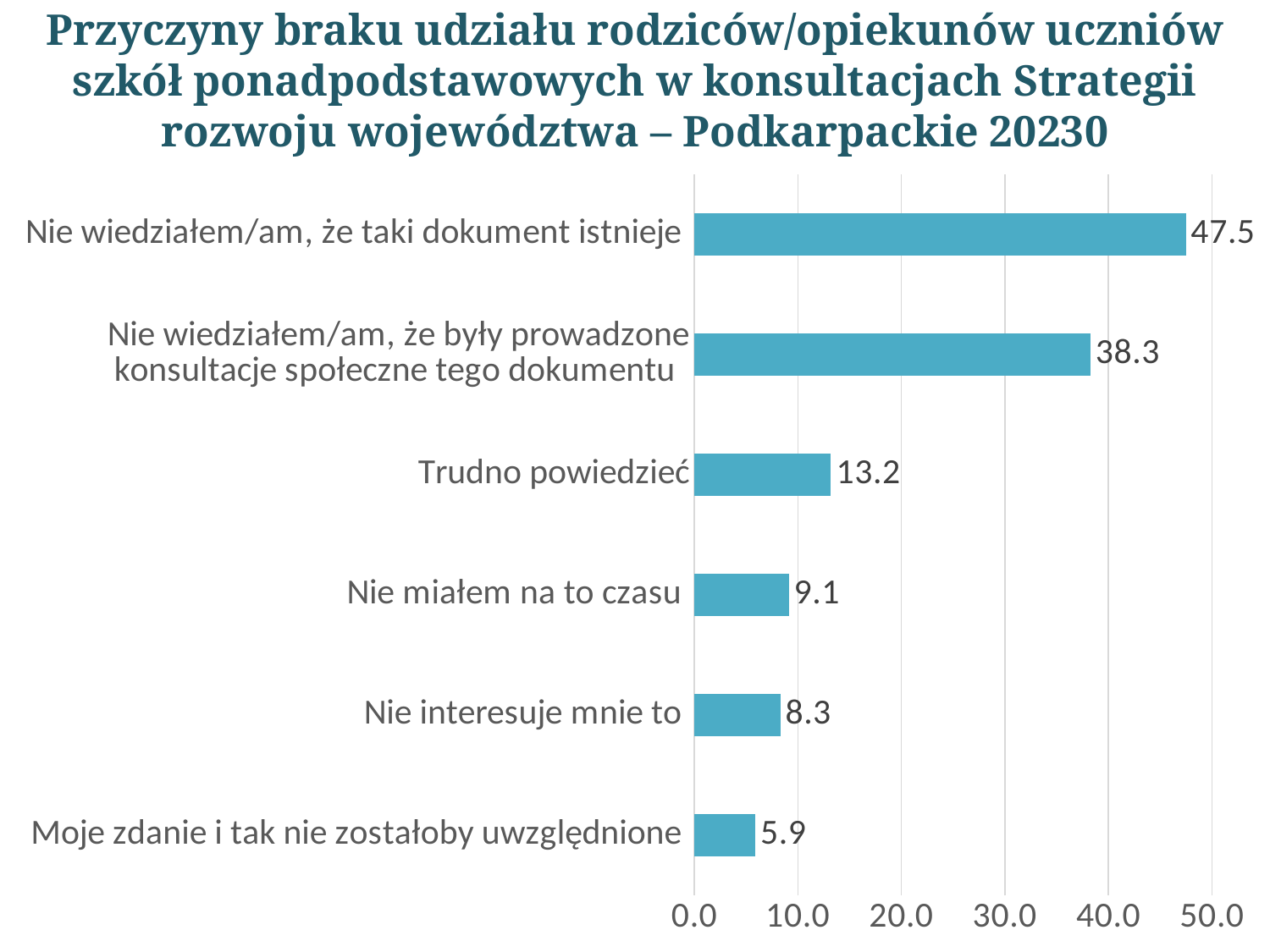
Which category has the lowest value? Moje zdanie i tak nie zostałoby uwzględnione What is the value for "Moje zdanie i tak nie zostałoby uwzględnione"? 5.9 What is the difference between the values for "Nie wiedziałem/am, że taki dokument istnieje" and "Nie wiedziałem/am, że były prowadzone konsultacje społeczne tego dokumentu"? 9.2 How many categories are shown in the chart? 6 Is the value for "Nie wiedziałem/am, że były prowadzone konsultacje społeczne tego dokumentu" greater or less than 40.0? less Which category has the highest value? Nie wiedziałem/am, że taki dokument istnieje What is the value for "Nie interesuje mnie to"? 8.3 What is the value for "Trudno powiedzieć"? 13.2 What is the difference between the values for "Nie miałem na to czasu" and "Nie interesuje mnie to"? 0.8 Which is larger: the value for "Trudno powiedzieć" or the value for "Nie miałem na to czasu"? Trudno powiedzieć What kind of chart is shown on the slide? bar chart What is the value for "Nie wiedziałem/am, że taki dokument istnieje"? 47.5